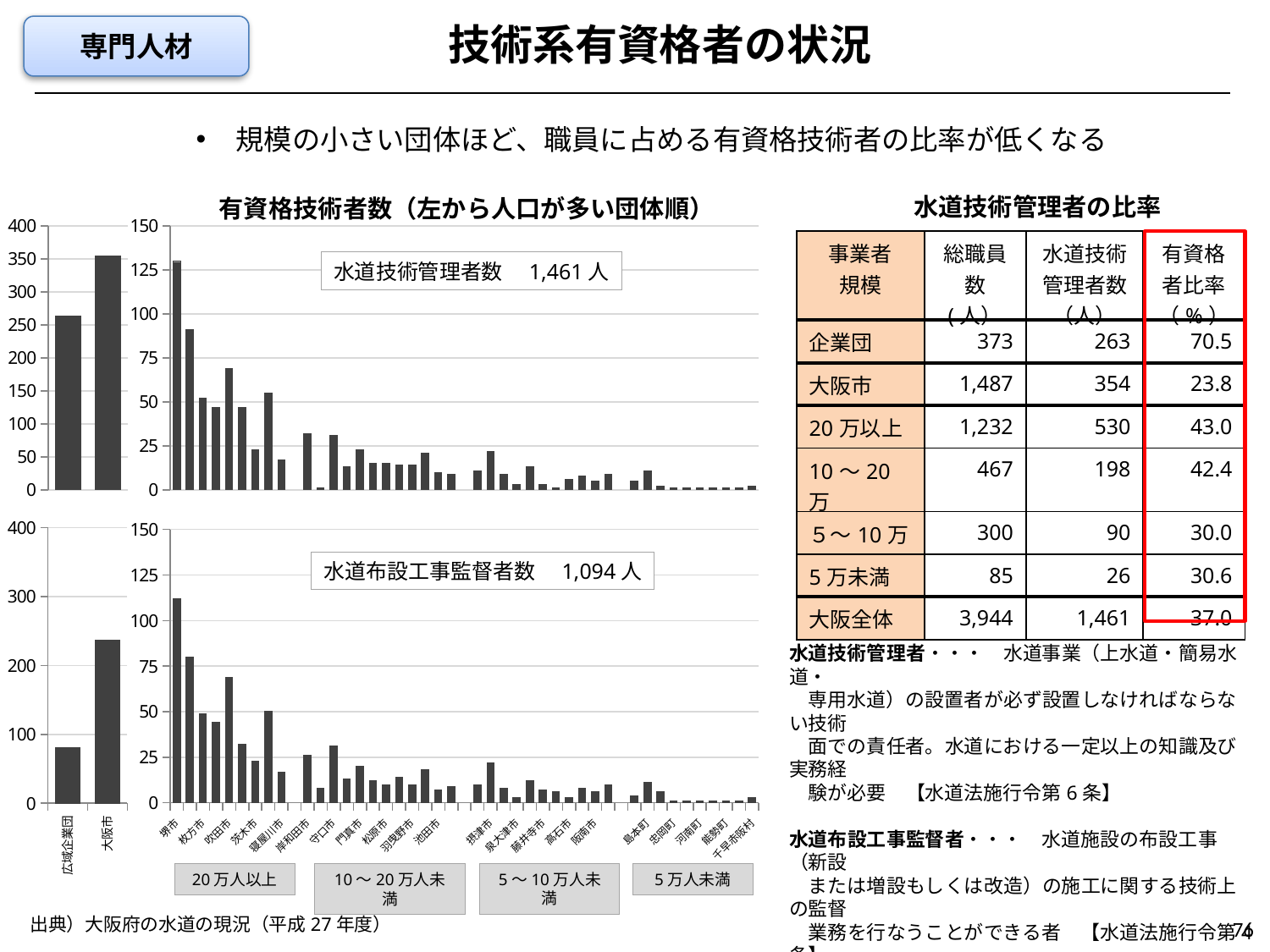
What kind of chart is used to show 水道技術管理者数 and 水道布設工事監督者数 on the slide? bar chart How many population-size groups are labelled beneath the bottom chart's x axis? 4 In the bottom chart (水道布設工事監督者数), is the value for 堺市 greater or less than 100? greater In the bottom chart (水道布設工事監督者数), do the bar values generally rise or fall from left to right across the municipalities? fall In the bottom chart (水道布設工事監督者数), which has the larger value, 吹田市 or 茨木市? 吹田市 In the top chart (水道技術管理者数), is the value for 大阪市 greater or less than 300? greater In the bottom chart (水道布設工事監督者数), which municipality in the right-hand panel (堺市 onward) has the highest bar? 堺市 In the top chart (水道技術管理者数), is the value for 広域企業団 greater or less than 200? greater What total number of 水道技術管理者 is printed in the label on the top chart? 1,461 人 In the top chart (水道技術管理者数), which has the taller bar, 広域企業団 or 大阪市? 大阪市